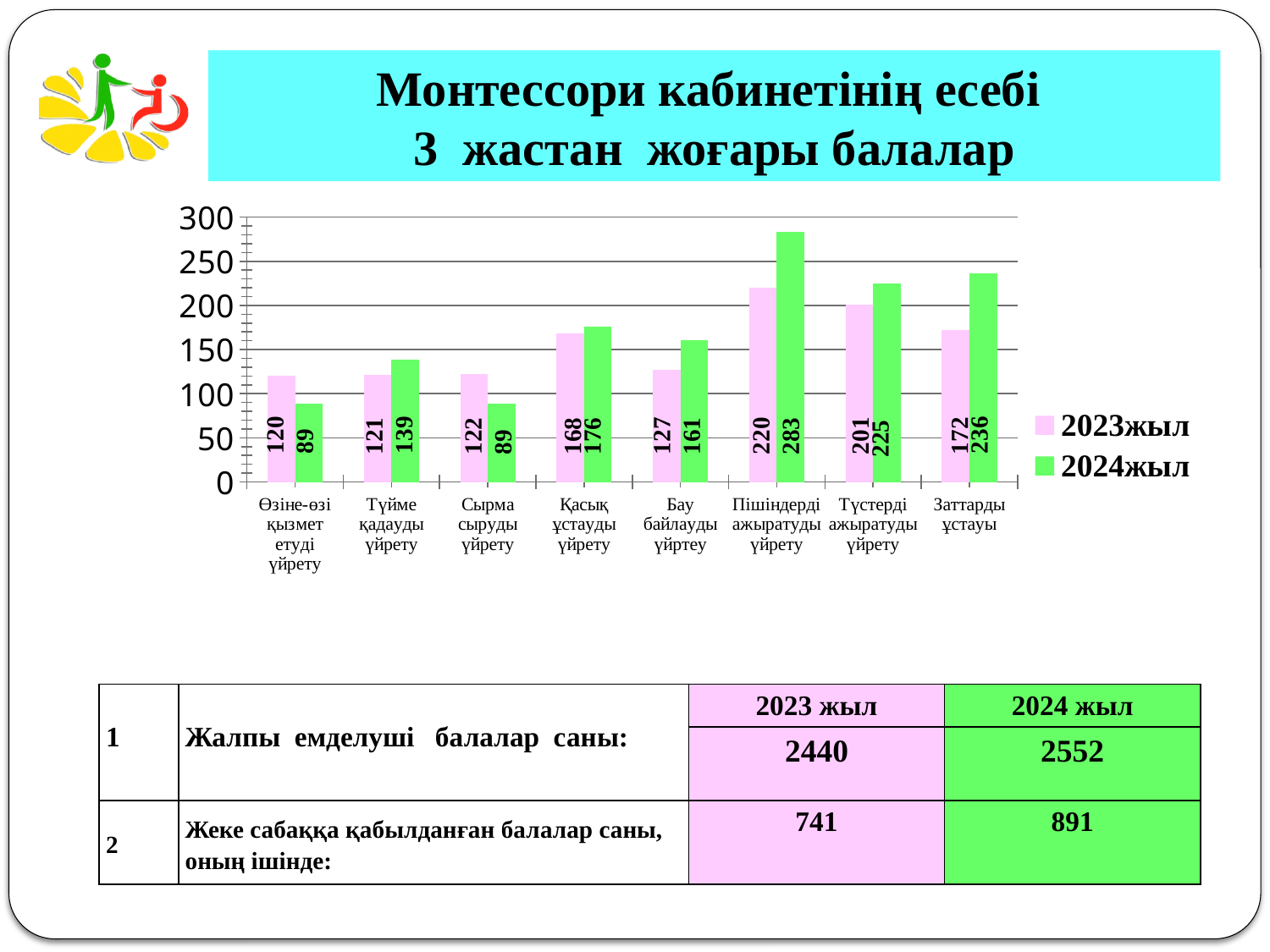
What is the 2023жыл value for Түстерді ажыратуды үйрету? 201 Is the 2024жыл value for Бау байлауды үйртеу greater or less than 150? greater What is the 2024жыл value for Пішіндерді ажыратуды үйрету? 283 What is the 2024жыл value for Сырма сыруды үйрету? 89 How many categories are shown on the x axis of the chart? 8 Which is larger for Өзіне-өзі қызмет етуді үйрету: the 2023жыл value or the 2024жыл value? 2023жыл What colour are the 2024жыл bars in the chart? green What kind of chart is shown on the slide? bar chart Which category has the lowest 2023жыл value? Өзіне-өзі қызмет етуді үйрету What is the difference between the 2024жыл and 2023жыл values for Заттарды ұстауы? 64 How many series does the chart legend list? 2 Which category has the highest 2024жыл value? Пішіндерді ажыратуды үйрету